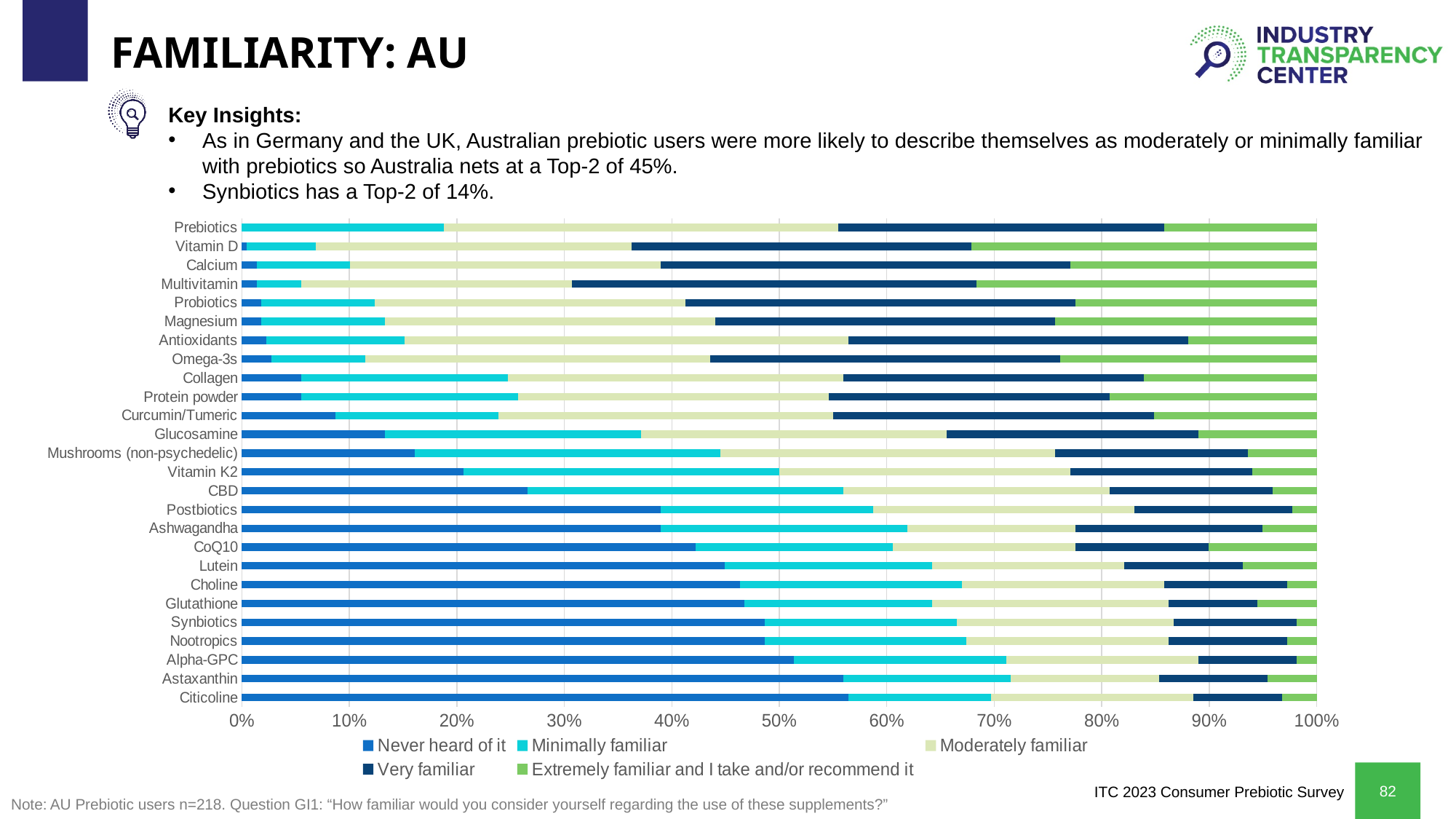
How many supplement categories are listed on the chart? 26 What does each stacked bar total on the x axis? 100% Which series is shown in green in the legend? Extremely familiar and I take and/or recommend it Is the 'Never heard of it' value for Citicoline greater or less than 50%? greater What kind of chart is shown on the slide? Stacked bar chart Which series is shown in the darkest blue colour in the legend? Very familiar Is the 'Never heard of it' value for Postbiotics greater or less than 30%? greater How many series does the chart legend list? 5 Which has a larger 'Never heard of it' share, Postbiotics or Glucosamine? Postbiotics Is the 'Never heard of it' value for Glucosamine greater or less than 20%? less Which has a larger 'Never heard of it' share, Astaxanthin or Collagen? Astaxanthin